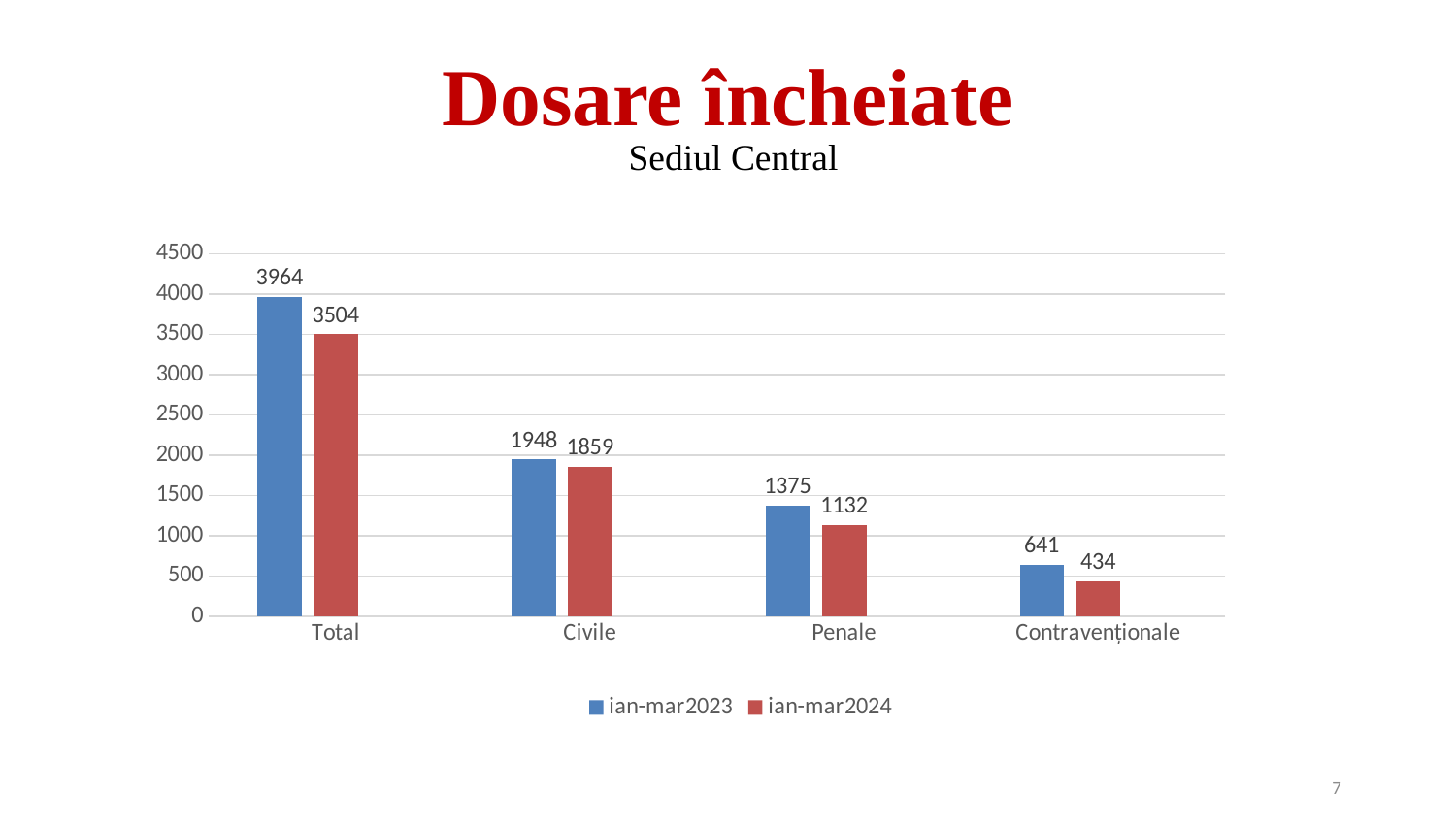
What is the difference between the ian-mar2023 and ian-mar2024 values for Total? 460 How many series does the legend list? 2 What is the value for Penale in the ian-mar2024 series? 1132 What is the value for Contravenționale in the ian-mar2023 series? 641 What is the value for Total in the ian-mar2023 series? 3964 Which category has the lowest value in the ian-mar2024 series? Contravenționale How many categories are shown on the x axis? 4 What is the difference between the ian-mar2023 and ian-mar2024 values for Civile? 89 Which category has the highest value in the ian-mar2023 series? Total Is the ian-mar2024 value for Civile greater or less than 2000? less What kind of chart is shown on the slide? bar chart Which is larger for Penale: the ian-mar2023 value or the ian-mar2024 value? ian-mar2023